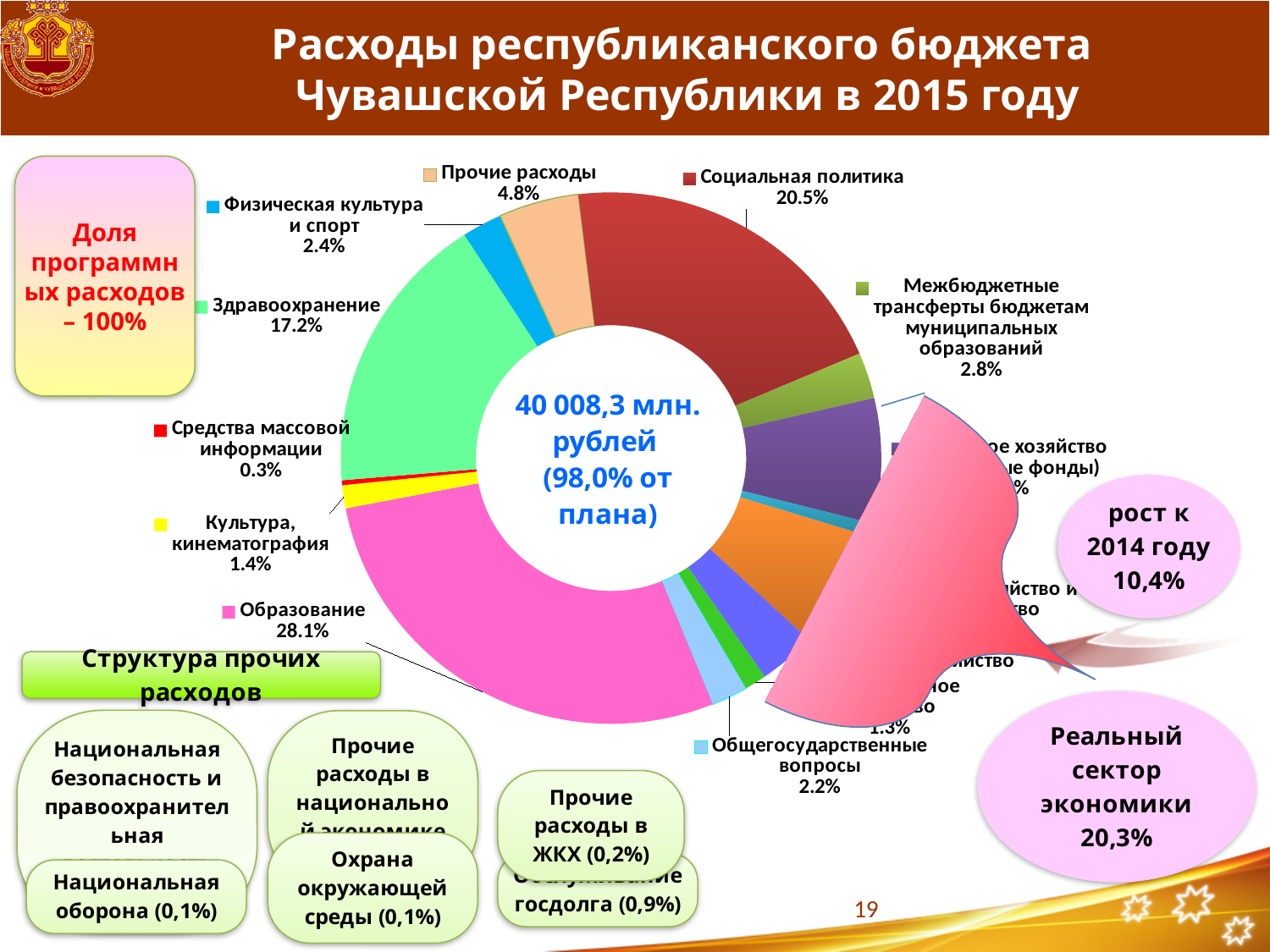
What share of expenditures does Здравоохранение account for? 17.2% What share of expenditures does Образование account for? 28.1% What share of expenditures does Общегосударственные вопросы account for? 2.2% What share of expenditures does Прочие расходы account for? 4.8% What share of expenditures does Средства массовой информации account for? 0.3% Which has a larger share, Здравоохранение or Социальная политика? Социальная политика What kind of chart is shown on the slide? Doughnut (pie) chart Which category has the largest share of expenditures? Образование What share of expenditures does Социальная политика account for? 20.5% What total amount is shown in the centre of the chart? 40 008,3 млн. рублей What is the difference in percentage points between Образование and Социальная политика? 7.6% What share of expenditures does Физическая культура и спорт account for? 2.4%